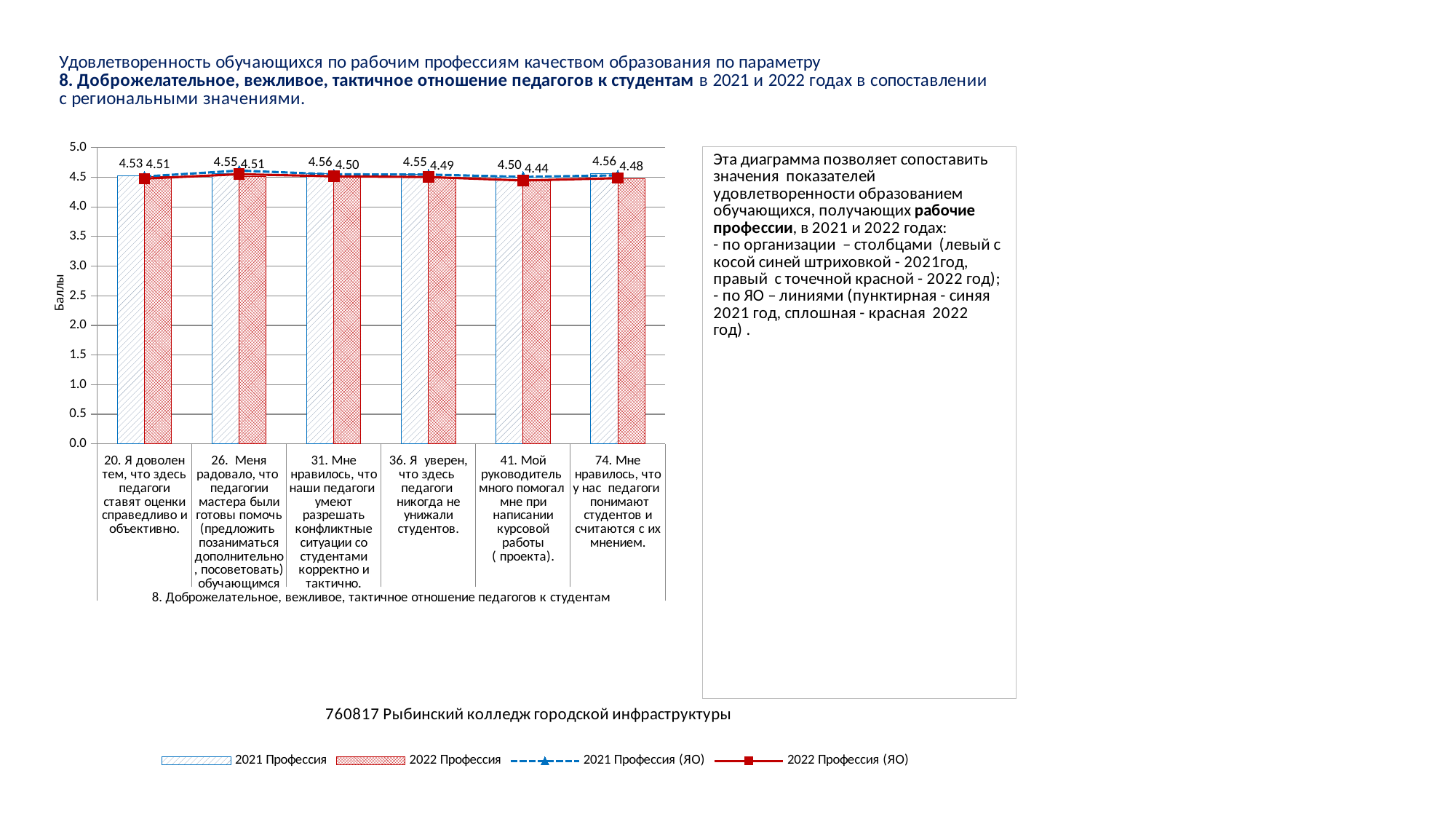
What kind of chart is shown on the slide? Bar chart with line series How many series does the chart legend list? 4 What is the name of the last series listed in the chart legend? 2022 Профессия (ЯО) For category 41, which of the two labelled values is larger, 4.50 or 4.44? 4.50 Is the value of the bars for category '36. Я уверен, что здесь педагоги никогда не унижали студентов.' greater or less than 4.0? greater What is the difference between the two data labels (4.50 and 4.44) shown for category 41? 0.06 Among the right-hand (second) data labels of each category, which category has the lowest value? 41. Мой руководитель много помогал мне при написании курсовой работы ( проекта). What is the title of the vertical (y) axis of the chart? Баллы What are the two data labels shown above the category '20. Я доволен тем, что здесь педагоги ставят оценки справедливо и объективно.'? 4.53 and 4.51 What are the two data labels shown above the category '41. Мой руководитель много помогал мне при написании курсовой работы ( проекта).'? 4.50 and 4.44 How many categories (survey statements) are shown on the x axis of the chart? 6 What is the highest tick value shown on the y axis of the chart? 5.0